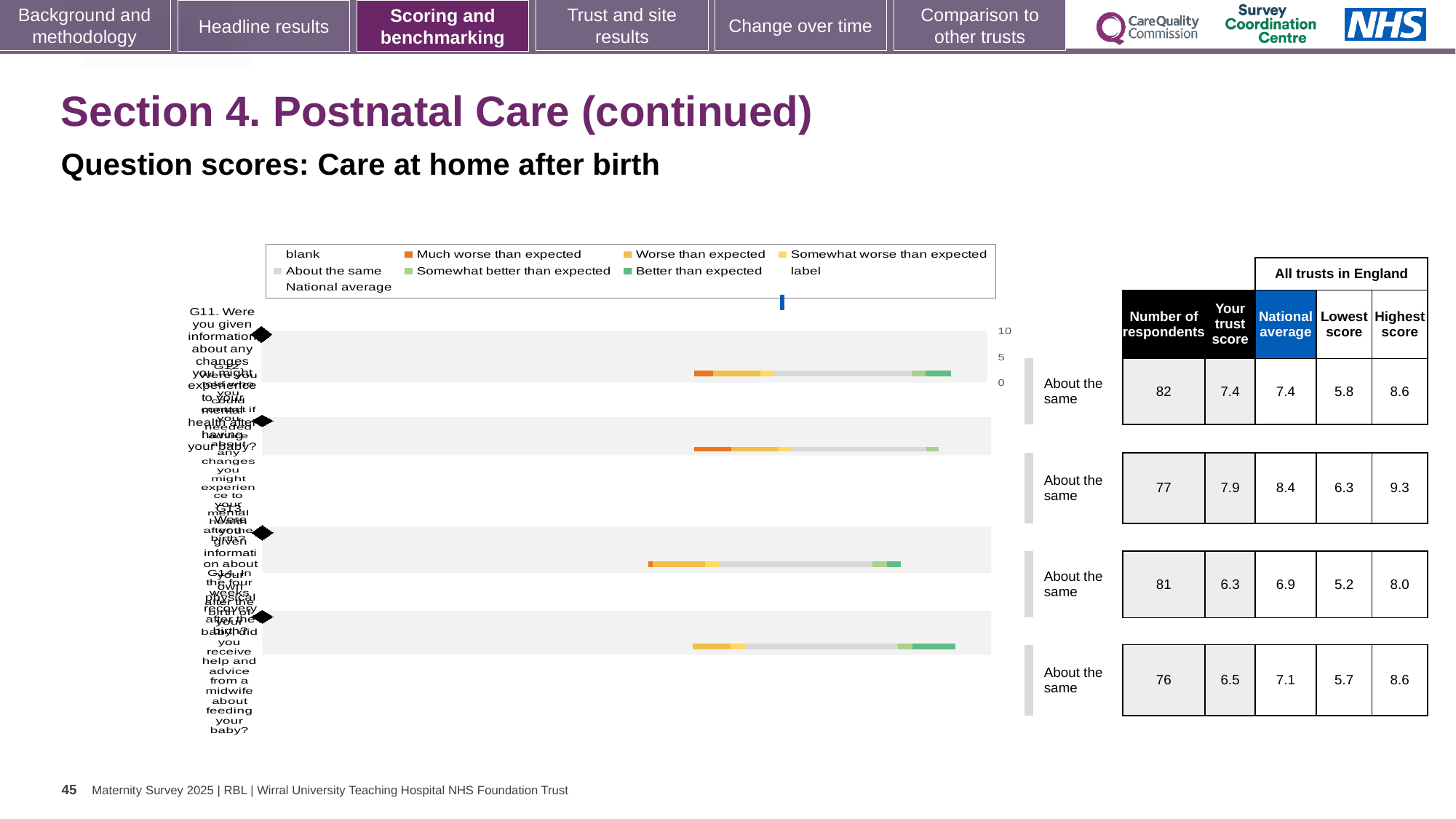
In the table beside the chart, which row has the lowest 'Your trust score'? the third row (6.3) In the table beside the chart, what is the difference between the national average and 'Your trust score' for the second row? 0.5 In the chart legend, what does the blue marker represent? National average In the table beside the chart, for the third row, which is larger: 'Your trust score' or the national average? National average In the chart legend, what colour is used for 'Much worse than expected'? orange In the table beside the chart, what is 'Your trust score' for the second row? 7.9 In the table beside the chart, what is the number of respondents for the first row? 82 What kind of chart is shown on the slide? bar chart How many question rows (bars) are plotted in the chart? 4 In the table beside the chart, which row has the highest 'Highest score' value? the second row (9.3) In the table beside the chart, what is the lowest score for the fourth row? 5.7 What benchmark category is shown next to each of the four bars in the chart? About the same